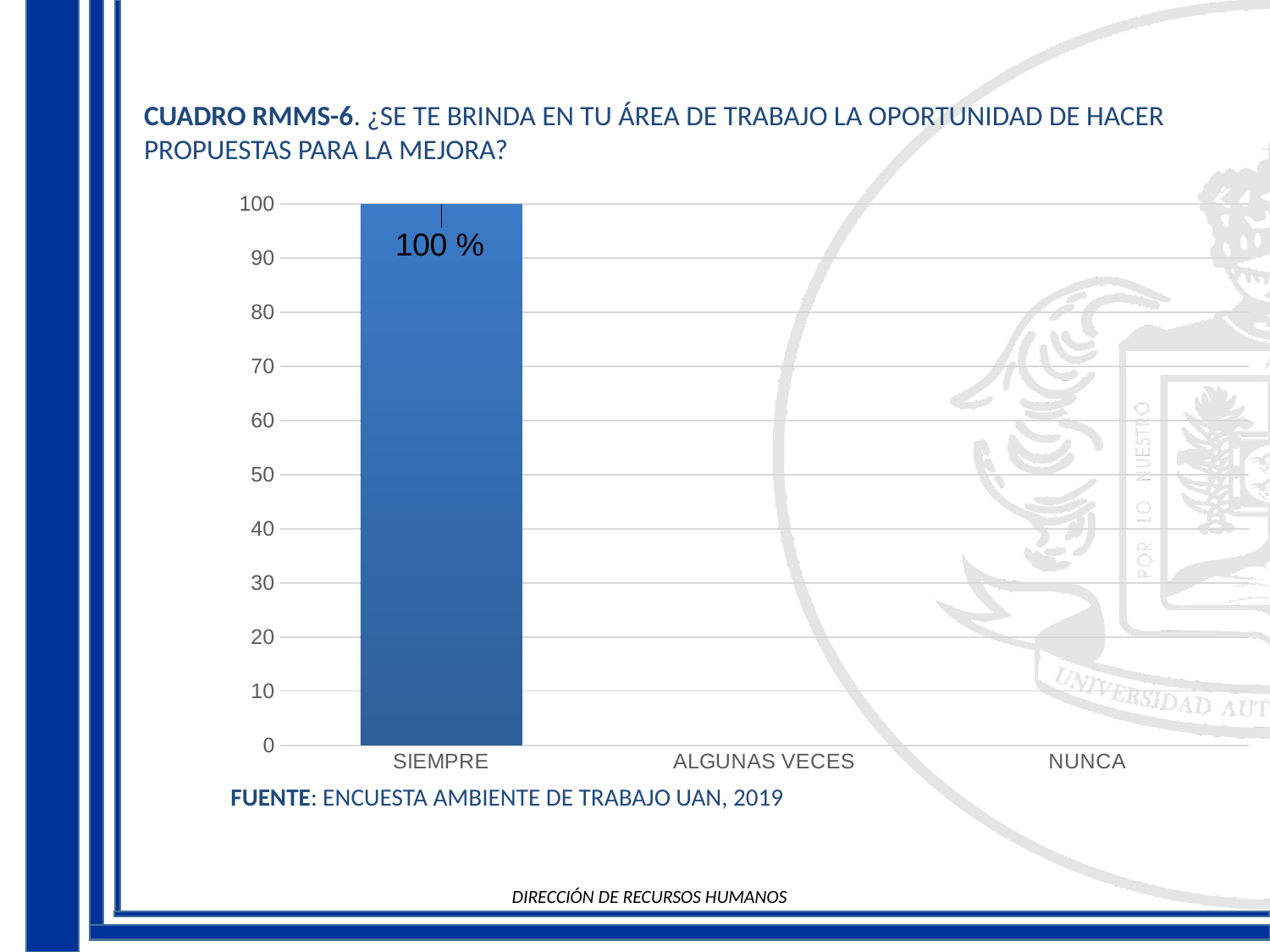
What is the value shown for SIEMPRE? 100 % Which category has the highest value? SIEMPRE How many categories are shown on the x axis? 3 What source is cited below the chart? ENCUESTA AMBIENTE DE TRABAJO UAN, 2019 What is the highest tick value shown on the vertical axis? 100 Is the value for SIEMPRE greater or less than 50? greater Which is larger, the value for SIEMPRE or the value for ALGUNAS VECES? SIEMPRE What kind of chart is shown on the slide? Bar chart Which is larger, the value for SIEMPRE or the value for NUNCA? SIEMPRE